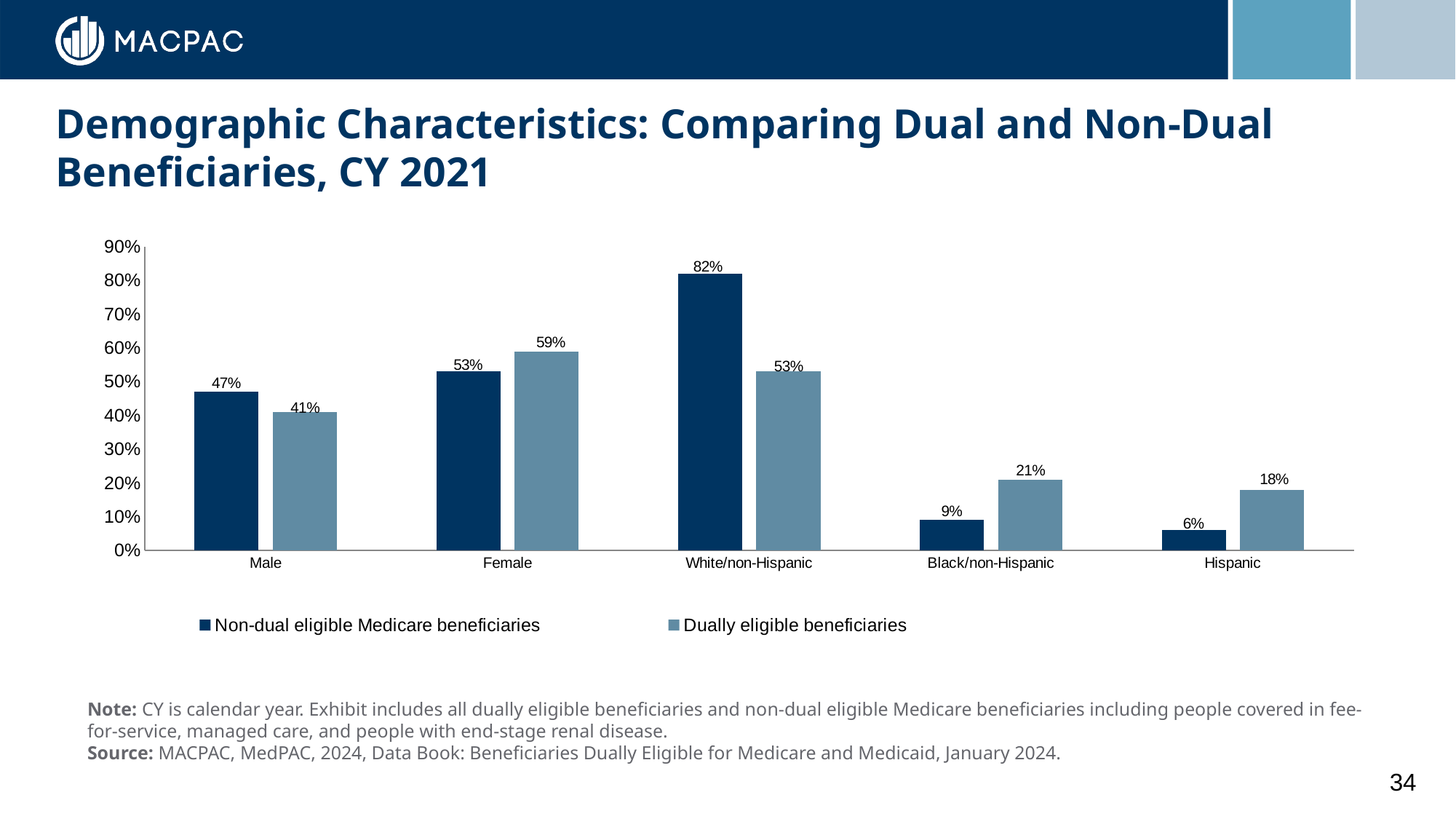
What is the value for Dually eligible beneficiaries in the Female category? 59% What is the difference between the Non-dual eligible and Dually eligible values in the White/non-Hispanic category? 29% Which category has the lowest value for Dually eligible beneficiaries? Hispanic What is the value for Dually eligible beneficiaries in the Black/non-Hispanic category? 21% What kind of chart is shown on the slide? Bar chart What is the difference between the Dually eligible and Non-dual eligible values in the Hispanic category? 12% How many categories are shown on the x axis? 5 In the Male category, which series has the larger value: Non-dual eligible Medicare beneficiaries or Dually eligible beneficiaries? Non-dual eligible Medicare beneficiaries How many series does the legend list? 2 What is the value for Non-dual eligible Medicare beneficiaries in the White/non-Hispanic category? 82% Which category has the highest value for Non-dual eligible Medicare beneficiaries? White/non-Hispanic What is the highest value shown on the y axis? 90%